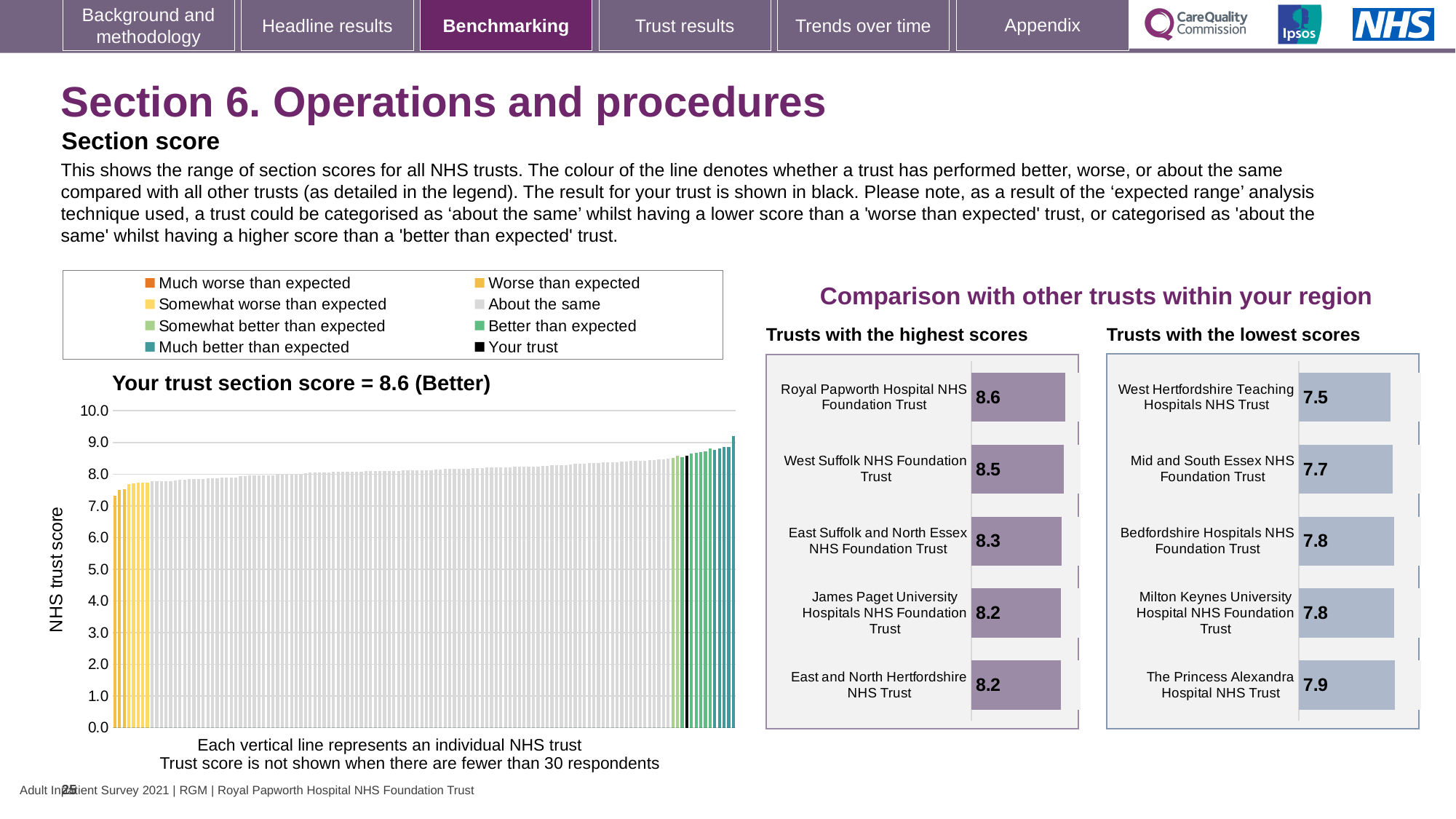
In the 'Trusts with the highest scores' chart, what is the score for Royal Papworth Hospital NHS Foundation Trust? 8.6 How many trusts are listed in the 'Trusts with the highest scores' chart? 5 In the main chart on the left, is the value of the lowest-scoring trust greater or less than 7.0? greater How many entries does the legend above the main chart on the left list? 8 In the 'Trusts with the highest scores' chart, what is the difference between the scores of Royal Papworth Hospital NHS Foundation Trust and West Suffolk NHS Foundation Trust? 0.1 In the 'Trusts with the highest scores' chart, which trust has the highest score? Royal Papworth Hospital NHS Foundation Trust What kind of chart is the 'Trusts with the lowest scores' chart? Bar chart In the 'Trusts with the highest scores' chart, what is the score for East Suffolk and North Essex NHS Foundation Trust? 8.3 In the 'Trusts with the lowest scores' chart, which trust has the lowest score? West Hertfordshire Teaching Hospitals NHS Trust In the 'Trusts with the lowest scores' chart, what is the difference between the scores of The Princess Alexandra Hospital NHS Trust and West Hertfordshire Teaching Hospitals NHS Trust? 0.4 In the 'Trusts with the lowest scores' chart, which has the larger score: Mid and South Essex NHS Foundation Trust or Bedfordshire Hospitals NHS Foundation Trust? Bedfordshire Hospitals NHS Foundation Trust In the 'Trusts with the lowest scores' chart, what is the score for Mid and South Essex NHS Foundation Trust? 7.7